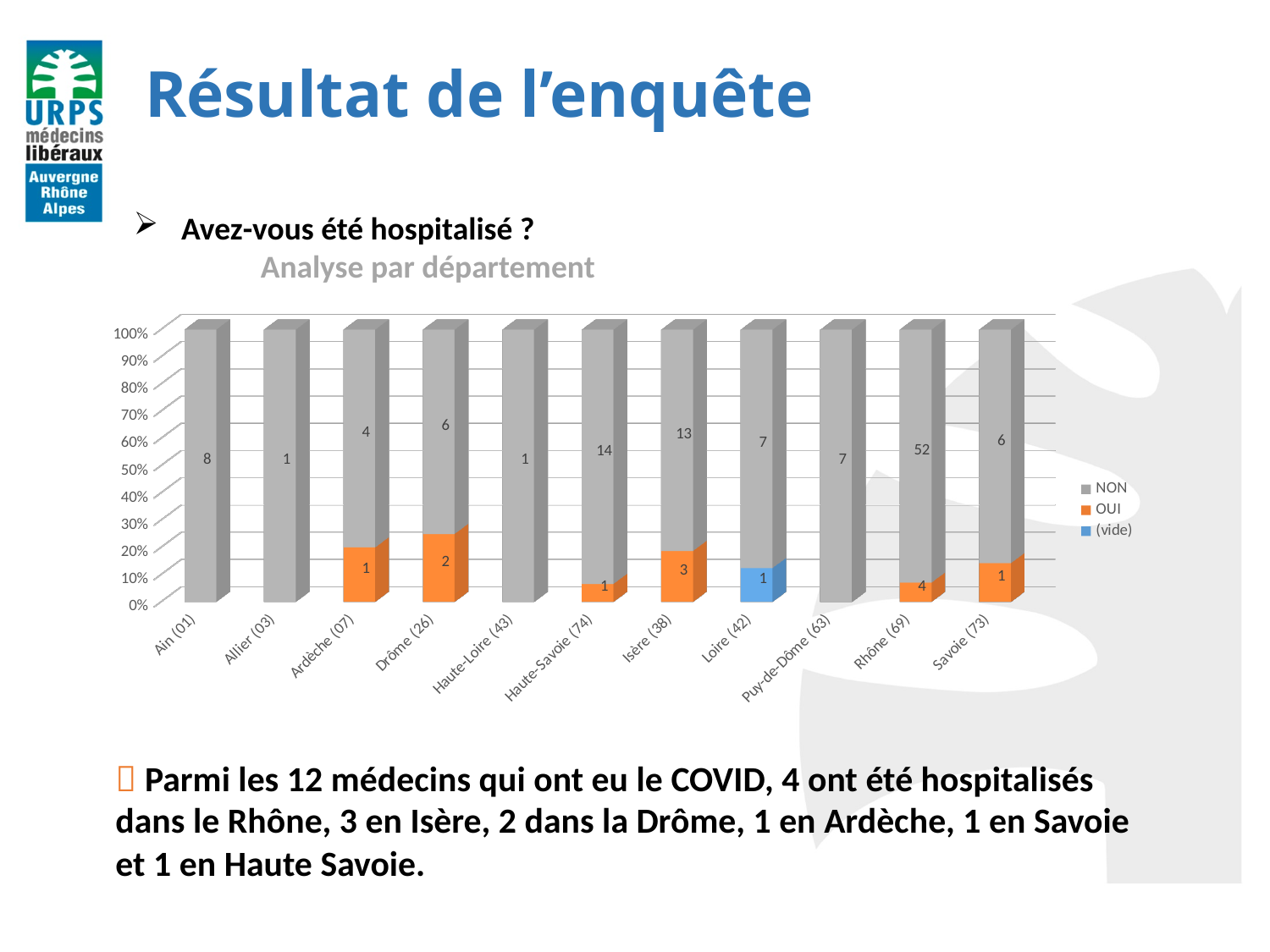
What is the difference between the NON values for Rhône (69) and Isère (38)? 39 Which department has the highest NON value? Rhône (69) What is the NON value for Haute-Savoie (74)? 14 What is the OUI value for Isère (38)? 3 Which department has the highest OUI value? Rhône (69) What is the total of the stacked bar for Rhône (69)? 56 What is the NON value for Rhône (69)? 52 How many series does the legend list? 3 How many departments are shown on the x axis? 11 Which is larger, the NON value for Ain (01) or the NON value for Drôme (26)? Ain (01) What is the (vide) value for Loire (42)? 1 What kind of chart is shown? Stacked bar chart